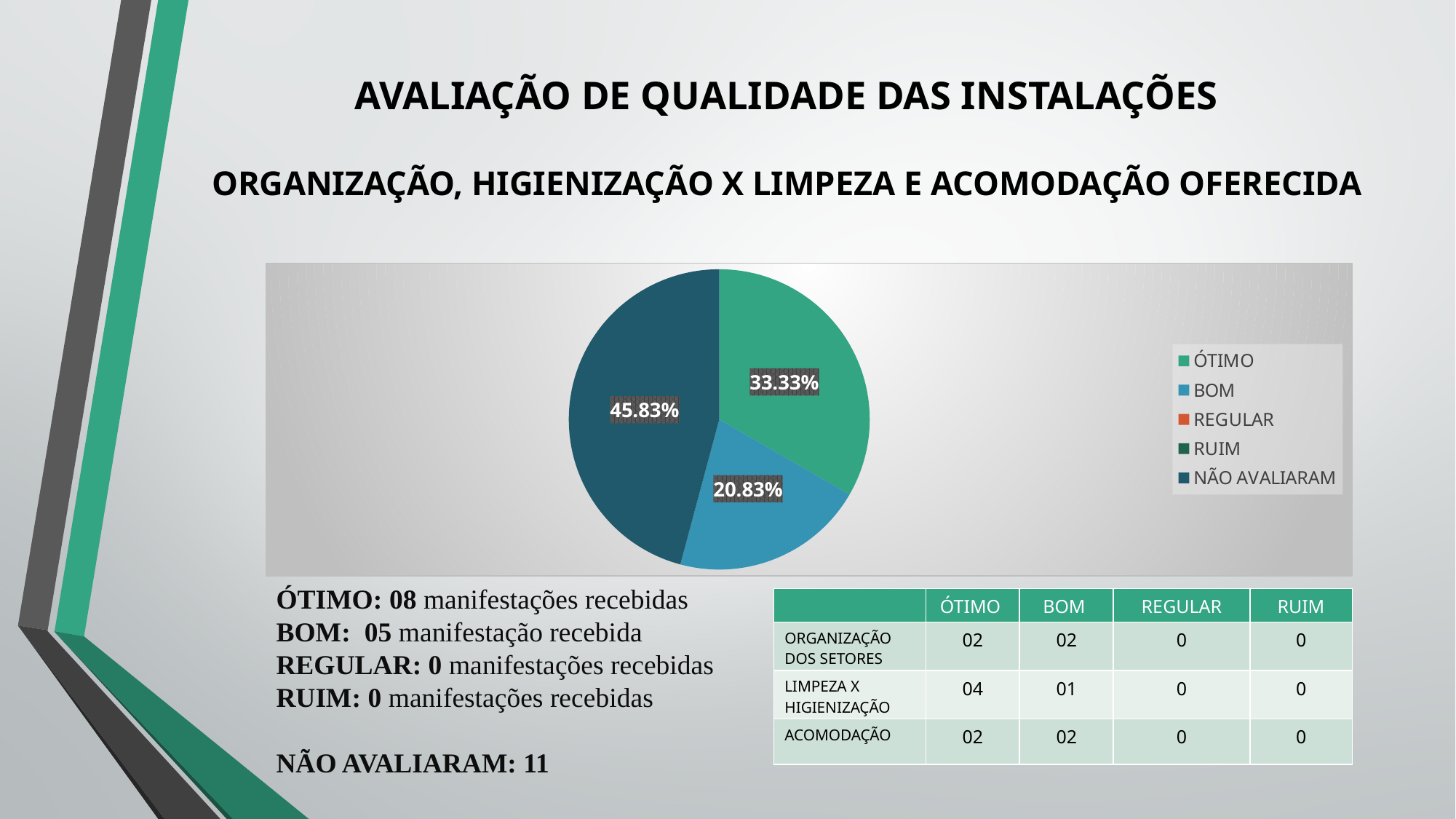
How many entries does the legend of the pie chart list? 5 What is the difference in percentage points between the NÃO AVALIARAM slice and the ÓTIMO slice? 12.50% What type of chart is shown on the slide? Pie chart Which category has the largest slice in the pie chart? NÃO AVALIARAM How many slices with data labels are visible in the pie chart? 3 Of the three labelled slices in the pie chart, which is the smallest? BOM Which legend entry is shown in orange? REGULAR What is the difference in percentage points between the ÓTIMO slice and the BOM slice? 12.50% What percentage of the pie chart does the BOM slice represent? 20.83% What percentage of the pie chart does the ÓTIMO slice represent? 33.33% What percentage of the pie chart does the NÃO AVALIARAM slice represent? 45.83% Which slice is larger, ÓTIMO or BOM? ÓTIMO